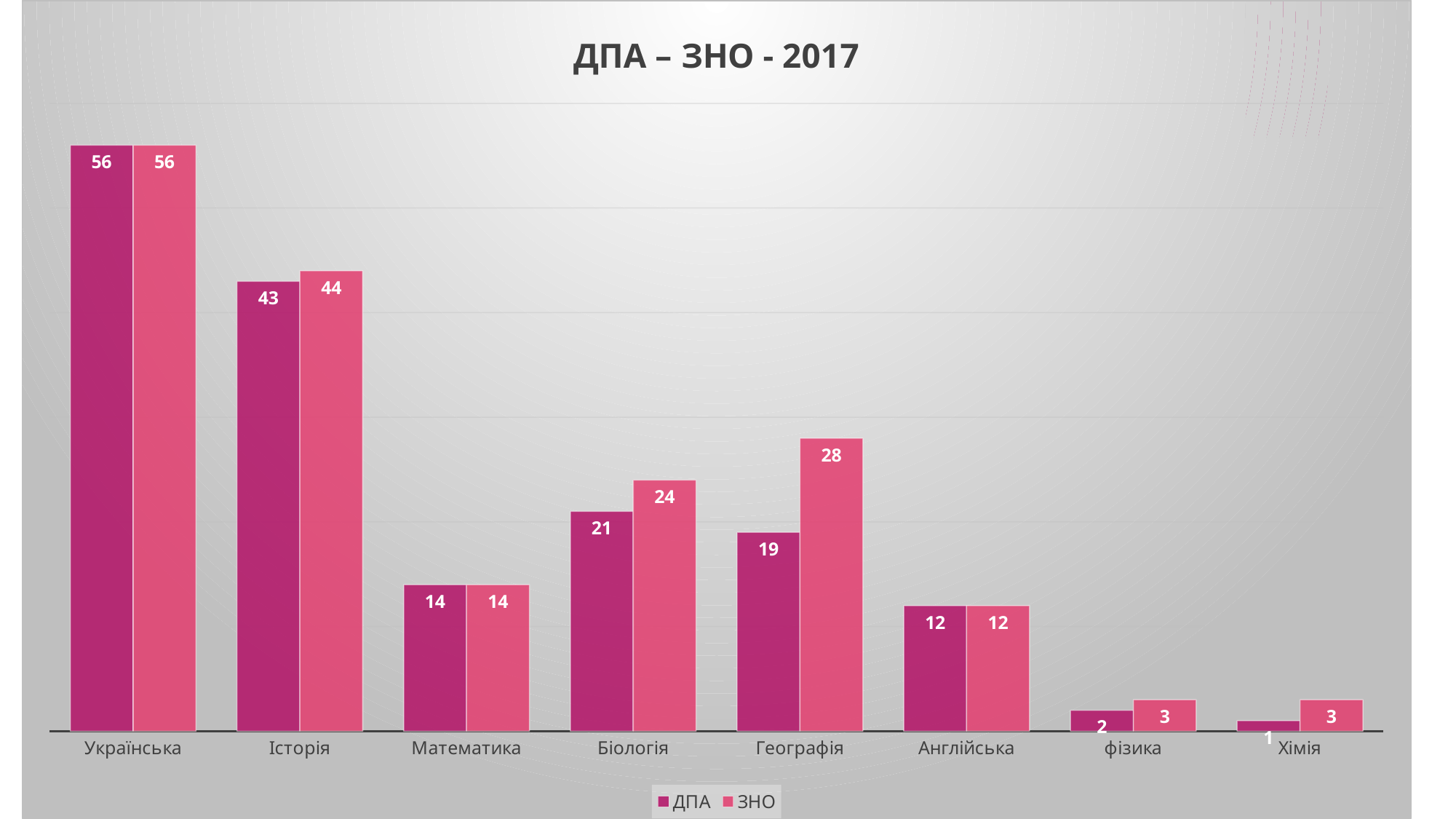
What kind of chart is shown on the slide? bar chart What is the difference between the ЗНО and ДПА values for Географія? 9 What is the ЗНО value for Географія? 28 What is the ДПА value for Історія? 43 What is the ЗНО value for Біологія? 24 What is the ДПА value for Англійська? 12 Which category has the highest ЗНО value? Українська How many categories are shown on the x axis? 8 Which is larger for Біологія, the ДПА value or the ЗНО value? ЗНО How many series does the legend list? 2 What is the title of the chart? ДПА – ЗНО - 2017 Which category has the lowest ДПА value? Хімія